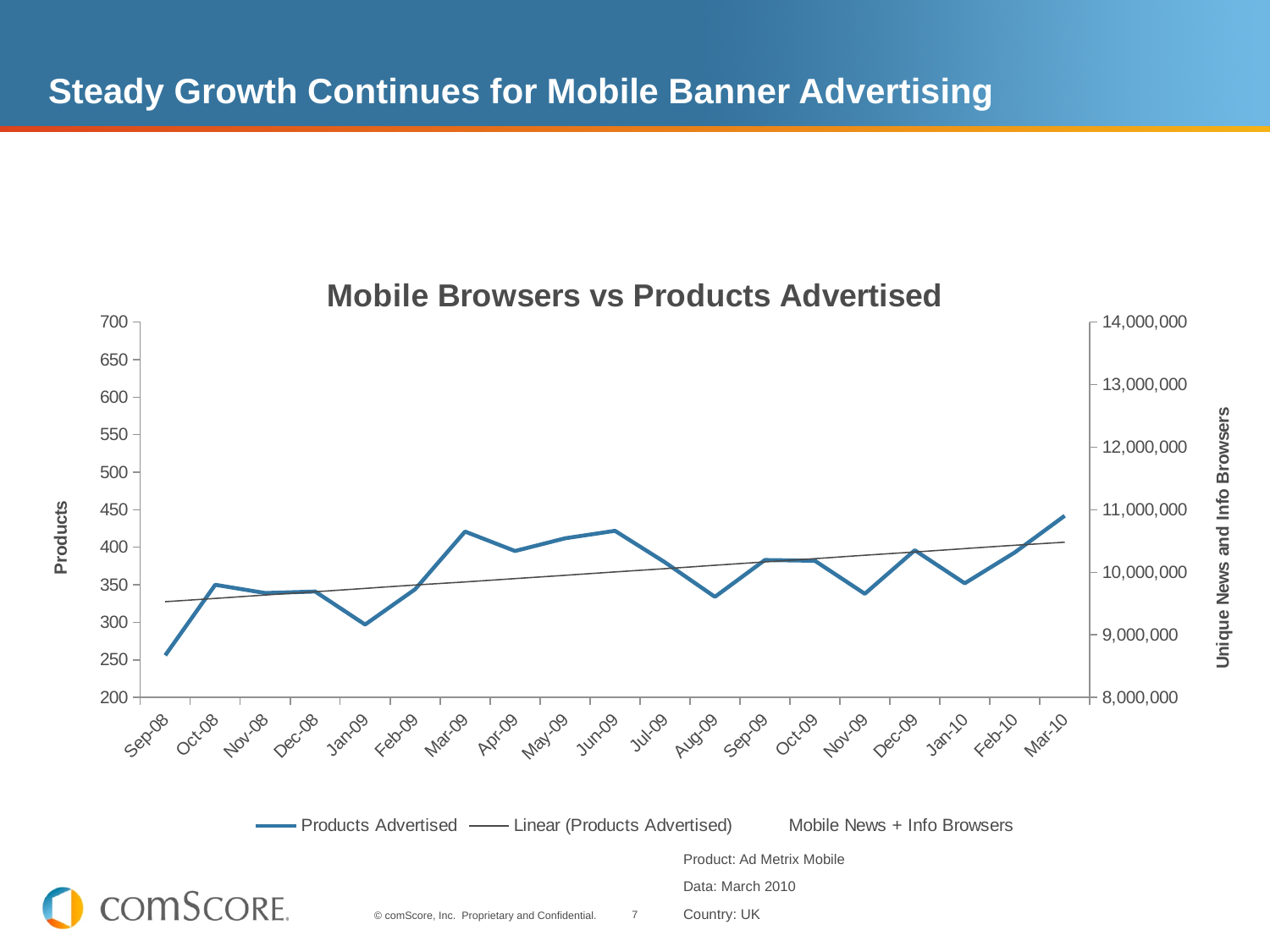
Overall, does the Products Advertised line rise or fall from Sep-08 to Mar-10? rise How many months are shown along the x axis of the chart? 19 What kind of chart is shown on the slide? line chart Is the Products Advertised value for Mar-09 greater or less than 400? greater How many entries does the chart legend list? 3 Is the Products Advertised value for Aug-09 greater or less than 350? less Which month has a larger Products Advertised value, Jan-09 or Mar-09? Mar-09 What is the label of the left vertical axis? Products In which month is the Products Advertised value lowest? Sep-08 Is the Products Advertised value for Sep-08 greater or less than 300? less In which month is the Products Advertised value highest? Mar-10 What is the title of the chart? Mobile Browsers vs Products Advertised